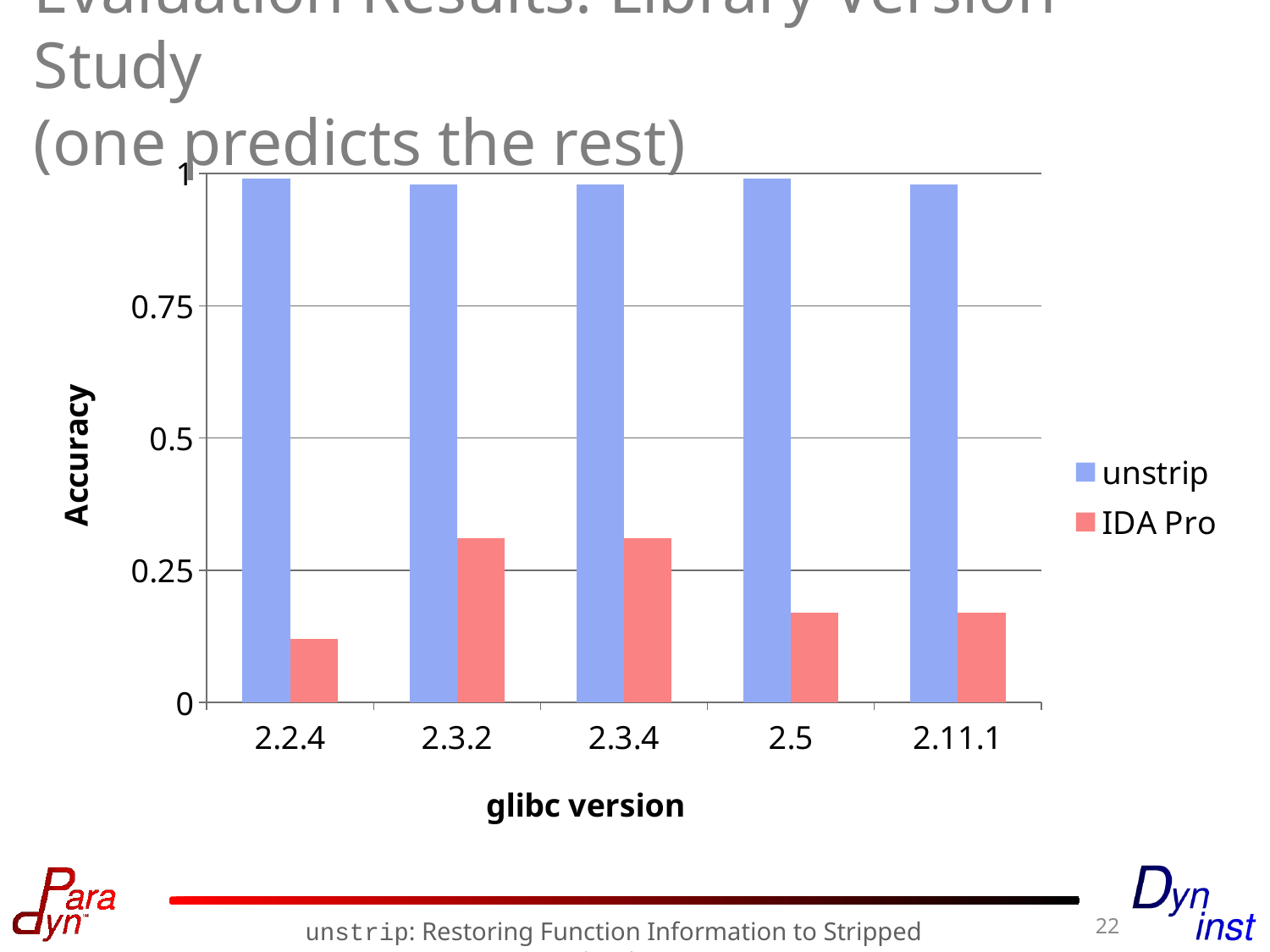
How many glibc versions are shown on the x axis? 5 For glibc version 2.3.4, which series has the larger value, unstrip or IDA Pro? unstrip How many series does the legend list? 2 Which is larger, the IDA Pro value for 2.3.2 or the IDA Pro value for 2.5? 2.3.2 Is the IDA Pro value for glibc version 2.11.1 greater or less than 0.5? less For which glibc version is the IDA Pro value lowest? 2.2.4 Is the IDA Pro value for glibc version 2.2.4 greater or less than 0.25? less What is the label of the y axis? Accuracy Is the unstrip value for glibc version 2.5 greater or less than 0.75? greater What kind of chart is shown on the slide? bar chart Which series does the legend list first? unstrip